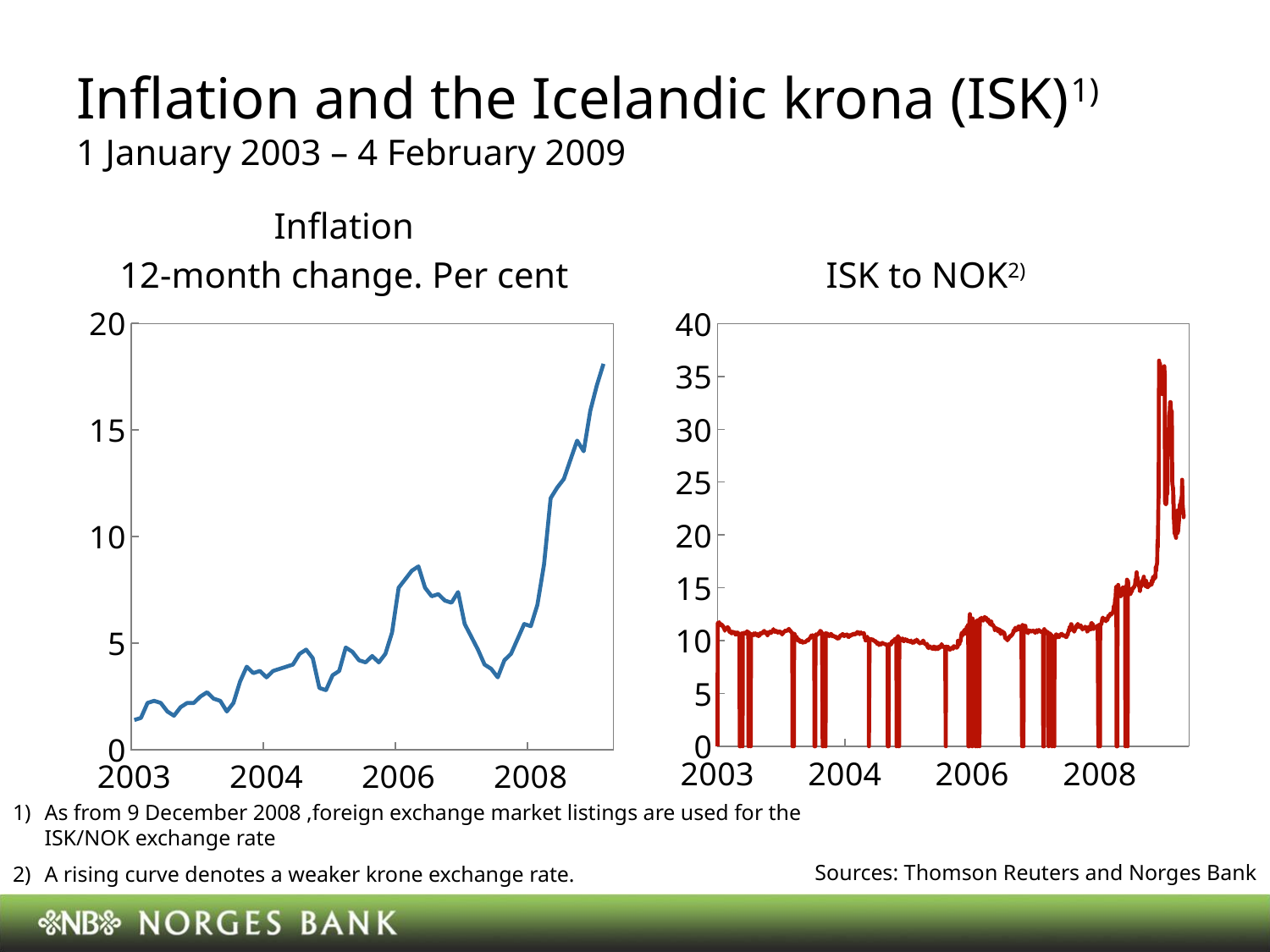
What is the maximum value shown on the y axis of the right chart (ISK to NOK)? 40 In the left chart (Inflation), is the value at the end of the series in early 2009 greater or less than 15? greater In the right chart (ISK to NOK), is the value at the start of 2006 greater or less than 20? less In the right chart (ISK to NOK), is the peak value in late 2008 greater or less than 30? greater What kind of chart is the left chart titled "Inflation"? line chart In the right chart (ISK to NOK), does the series rise or fall during 2008? rise What colour is the line in the left chart (Inflation)? blue What kind of chart is the right chart titled "ISK to NOK"? line chart In the left chart (Inflation), does the series overall rise or fall from 2003 to 2009? rise